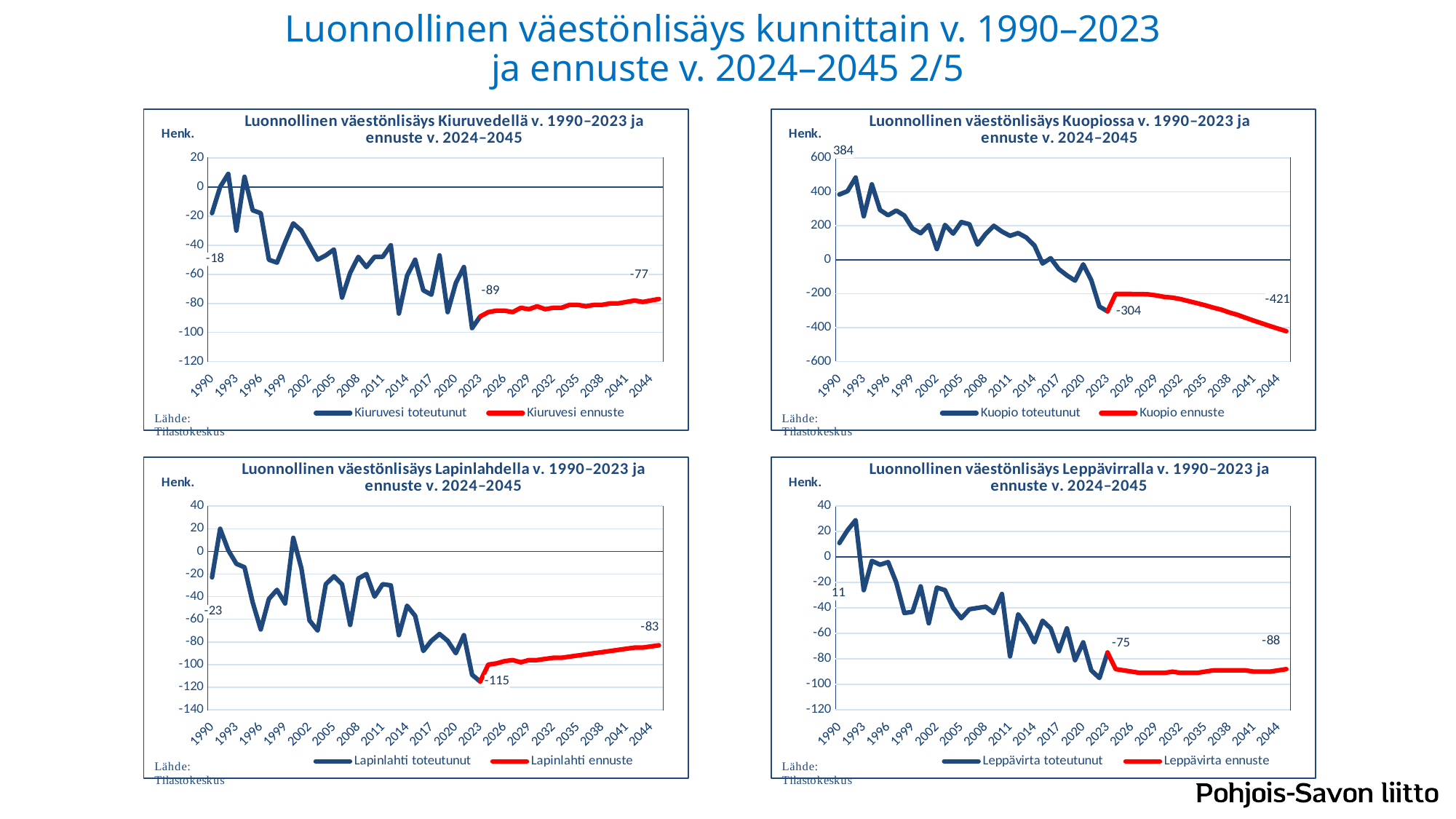
In the Kuopio chart (top right), what is the labelled value at the end of the forecast in 2044? -421 In the Leppävirta chart (bottom right), what is the labelled value at the end of the forecast in 2044? -88 In the Lapinlahti chart (bottom left), what value is labelled at the junction of the actual and forecast lines? -115 In the Kuopio chart (top right), what is the difference between the labelled 1990 value (384) and the labelled 2044 forecast value (-421)? 805 In the Leppävirta chart (bottom right), what are the two legend entries? Leppävirta toteutunut, Leppävirta ennuste How many series does the legend list in the Lapinlahti chart (bottom left)? 2 Which is larger: the labelled 1990 value in the Kuopio chart or the labelled 1990 value in the Leppävirta chart? Kuopio (384) In the Kuopio chart (top right), does the red forecast line rise or fall from 2029 to 2044? fall In the Kuopio chart (top right), what is the labelled value for 1990? 384 What type of chart is used in the Kuopio chart (top right)? line chart In the Kiuruvesi chart (top left), what is the labelled value for 1990? -18 In the Kiuruvesi chart (top left), does the red forecast line rise or fall from 2024 to 2044? rise